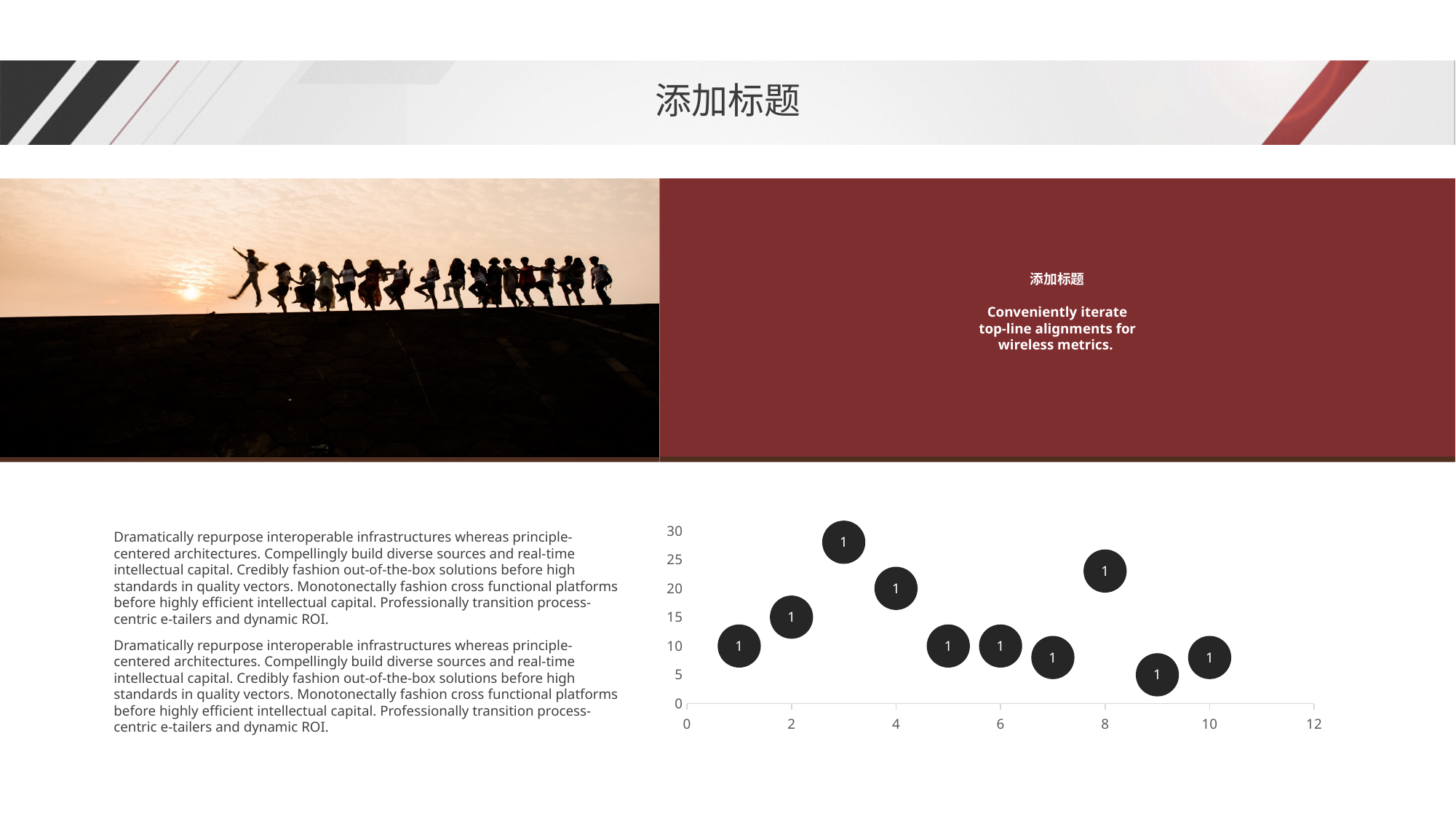
At which x value does the chart's highest bubble appear? 3 What kind of chart is shown at the bottom right of the slide? bubble chart Which bubble is higher on the y axis, the one at x = 4 or the one at x = 2? x = 4 Which bubble is higher on the y axis, the one at x = 3 or the one at x = 8? x = 3 Is the y value of the bubble at x = 3 greater or less than 25? greater At which x value does the chart's lowest bubble appear? 9 Is the y value of the bubble at x = 8 greater or less than 20? greater Is the y value of the bubble at x = 2 greater or less than 20? less What label is printed inside each bubble in the chart? 1 How many bubbles are plotted in the chart? 10